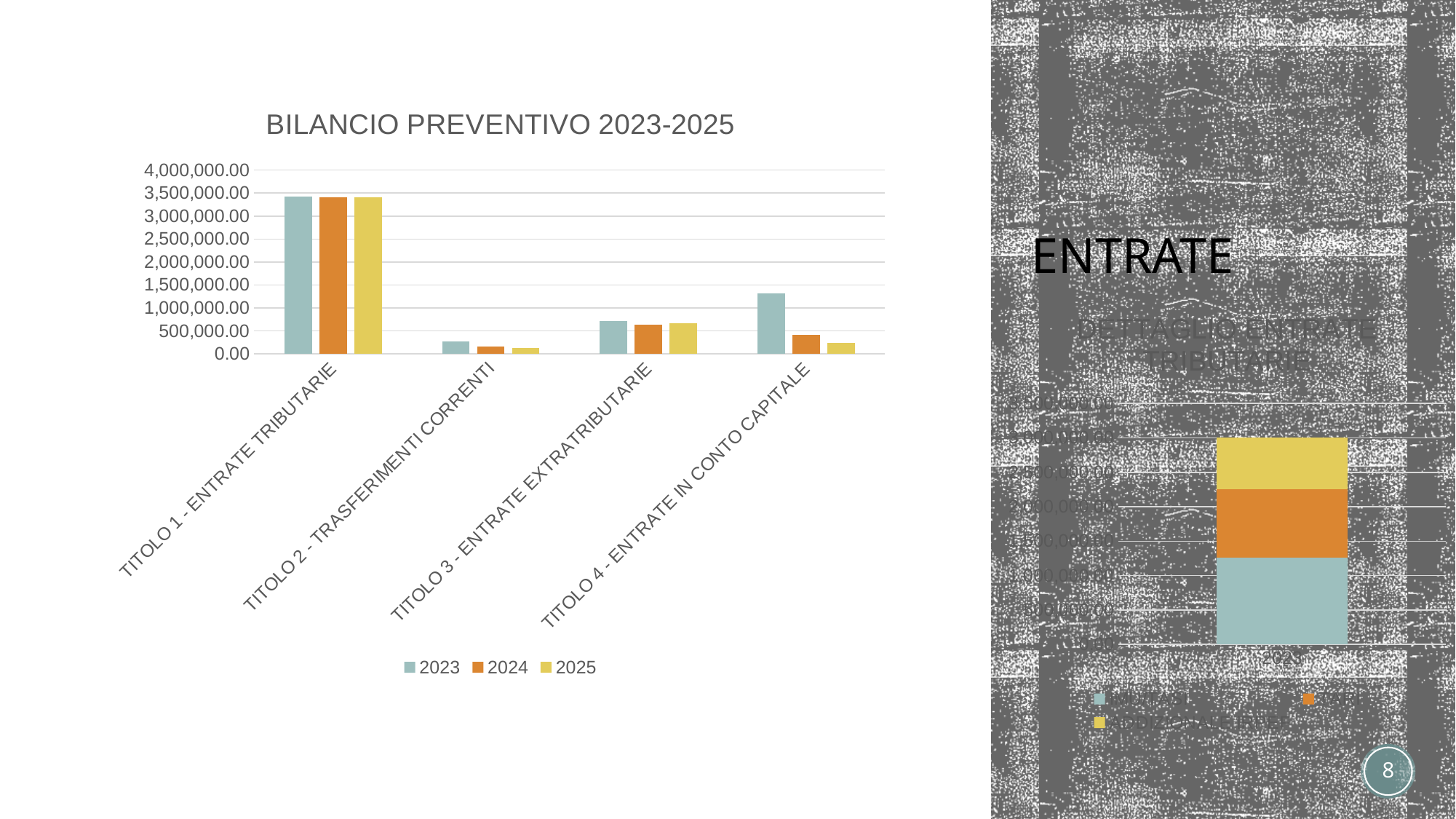
In the chart titled BILANCIO PREVENTIVO 2023-2025, which category has the lowest value for 2025? TITOLO 2 - TRASFERIMENTI CORRENTI In the chart titled BILANCIO PREVENTIVO 2023-2025, what kind of chart is shown? bar chart What is the title of the chart on the left side of the slide? BILANCIO PREVENTIVO 2023-2025 In the chart titled BILANCIO PREVENTIVO 2023-2025, is the 2024 value for TITOLO 2 - TRASFERIMENTI CORRENTI greater or less than 500,000.00? less In the chart titled BILANCIO PREVENTIVO 2023-2025, how many series does the legend list? 3 In the chart titled BILANCIO PREVENTIVO 2023-2025, is the 2023 value for TITOLO 4 - ENTRATE IN CONTO CAPITALE greater or less than 1,000,000.00? greater In the chart titled BILANCIO PREVENTIVO 2023-2025, which category has the highest value for 2023? TITOLO 1 - ENTRATE TRIBUTARIE In the chart titled BILANCIO PREVENTIVO 2023-2025, for TITOLO 4 - ENTRATE IN CONTO CAPITALE, which year has the larger value, 2023 or 2024? 2023 In the chart titled BILANCIO PREVENTIVO 2023-2025, which series is shown in orange? 2024 In the chart titled BILANCIO PREVENTIVO 2023-2025, do the values for TITOLO 4 - ENTRATE IN CONTO CAPITALE rise or fall from 2023 to 2025? fall In the chart titled BILANCIO PREVENTIVO 2023-2025, is the 2023 value for TITOLO 1 - ENTRATE TRIBUTARIE greater or less than 3,000,000.00? greater In the chart titled BILANCIO PREVENTIVO 2023-2025, how many categories are shown on the x axis? 4